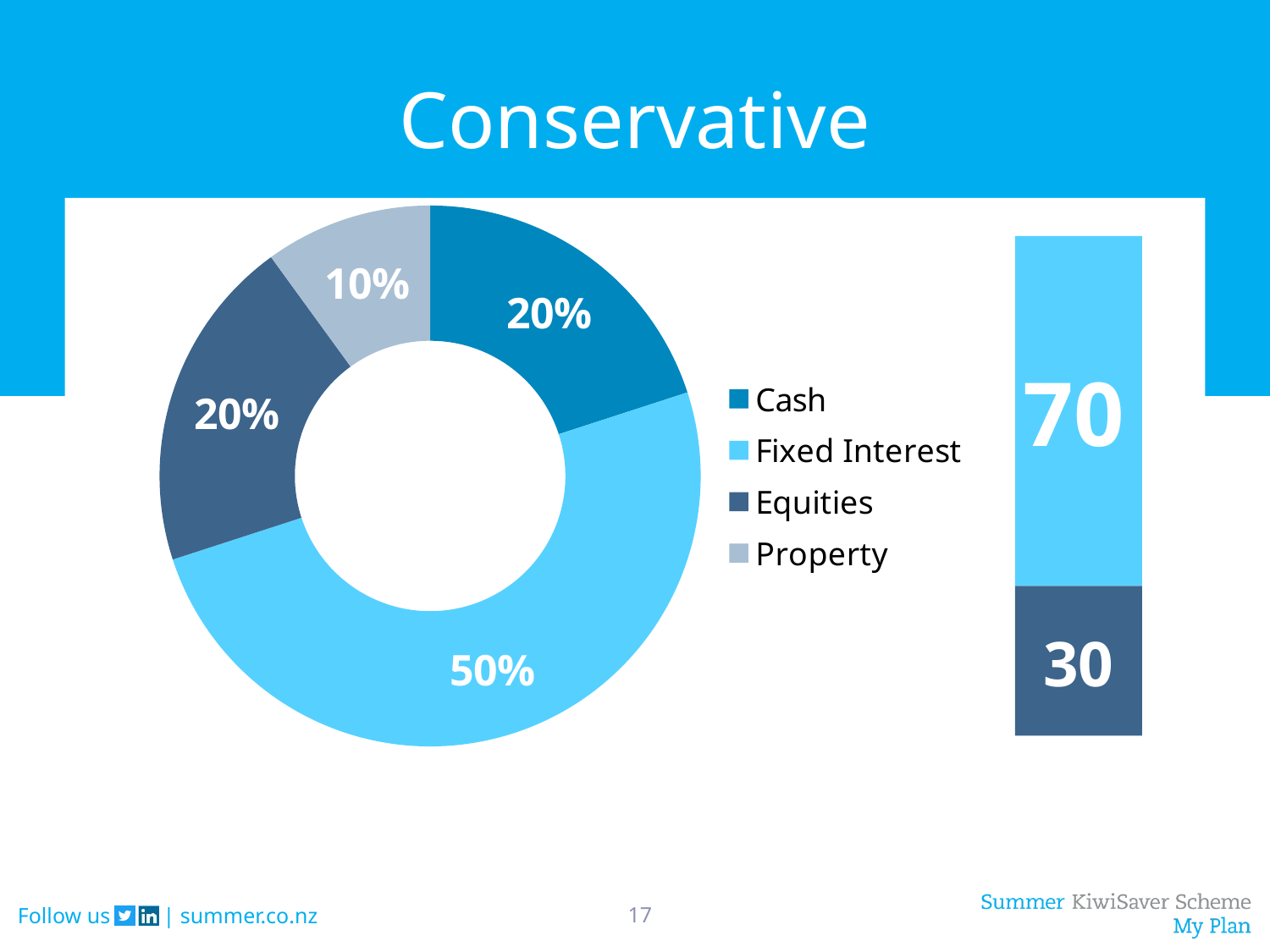
In the donut chart, what share does Cash have? 20% How many categories does the donut chart's legend list? 4 In the donut chart, what share does Property have? 10% In the stacked bar on the right of the slide, what is the value of the top (light blue) segment? 70 In the donut chart, which category has the largest share? Fixed Interest In the donut chart, which is larger, the share for Cash or the share for Property? Cash In the donut chart, what is the difference between the Fixed Interest share and the Equities share? 30% In the donut chart, what share does Fixed Interest have? 50% What kind of chart is the chart on the left of the slide? Donut (pie) chart In the stacked bar on the right of the slide, what is the total of the two segments? 100 In the donut chart, which category has the smallest share? Property What is the title of the slide containing the charts? Conservative